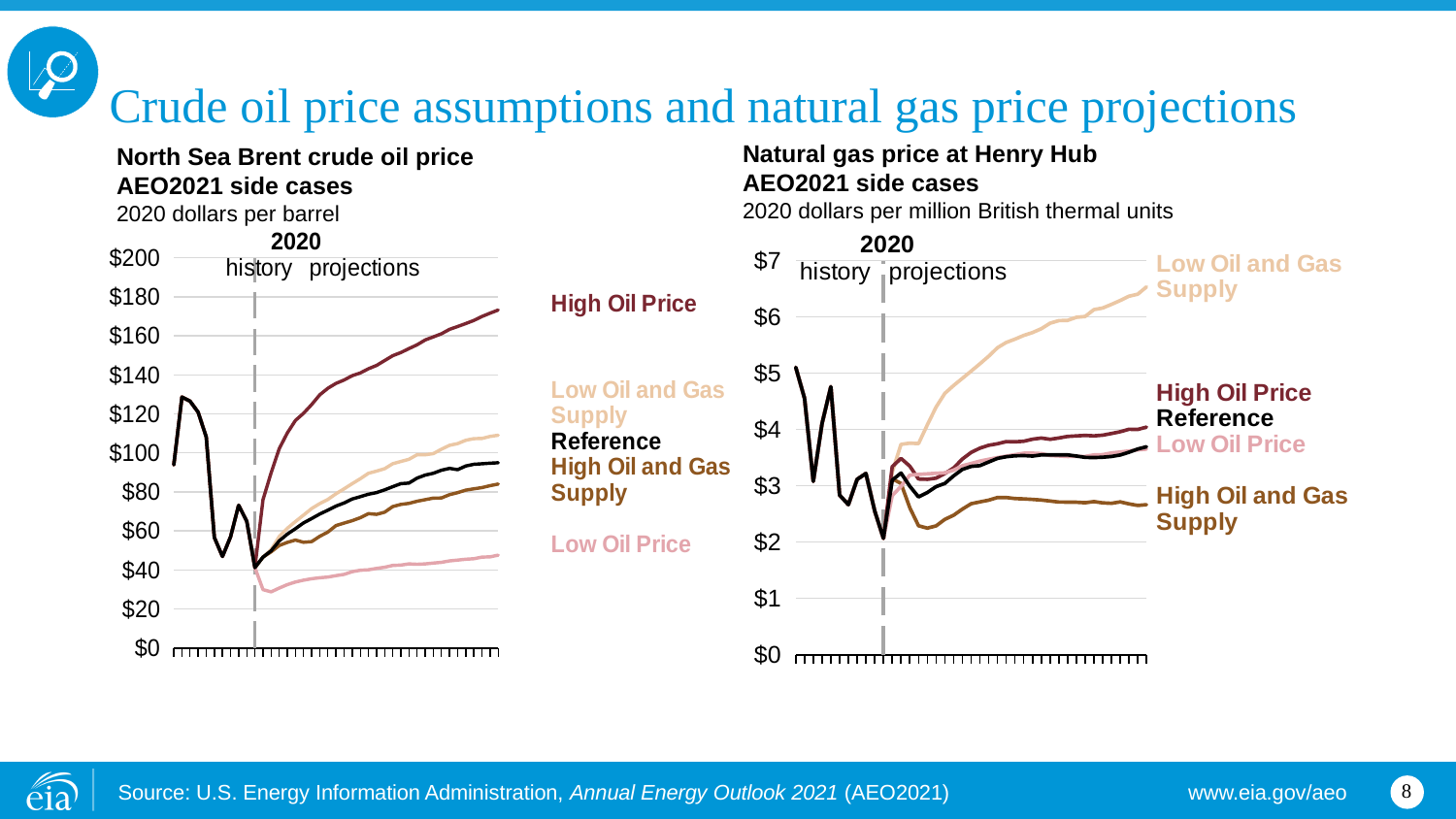
On the Natural gas price at Henry Hub chart, is the High Oil and Gas Supply value at the end of the projections greater or less than $3? less On the North Sea Brent crude oil price chart, is the High Oil Price value at the end of the projections greater or less than $160? greater On the North Sea Brent crude oil price chart, which case has the highest price at the end of the projection period? High Oil Price How many side cases (series) are labeled on the Natural gas price at Henry Hub chart? 5 What units are used on the Natural gas price at Henry Hub chart? 2020 dollars per million British thermal units On the Natural gas price at Henry Hub chart, which case has the highest price at the end of the projection period? Low Oil and Gas Supply What kind of chart is the North Sea Brent crude oil price chart? line chart On the Natural gas price at Henry Hub chart, which case has the lowest price at the end of the projection period? High Oil and Gas Supply On the North Sea Brent crude oil price chart, does the High Oil Price case rise or fall over the projection period? rise On the Natural gas price at Henry Hub chart, is the Low Oil and Gas Supply value at the end of the projections greater or less than $6? greater On the North Sea Brent crude oil price chart, which case has the lowest price at the end of the projection period? Low Oil Price